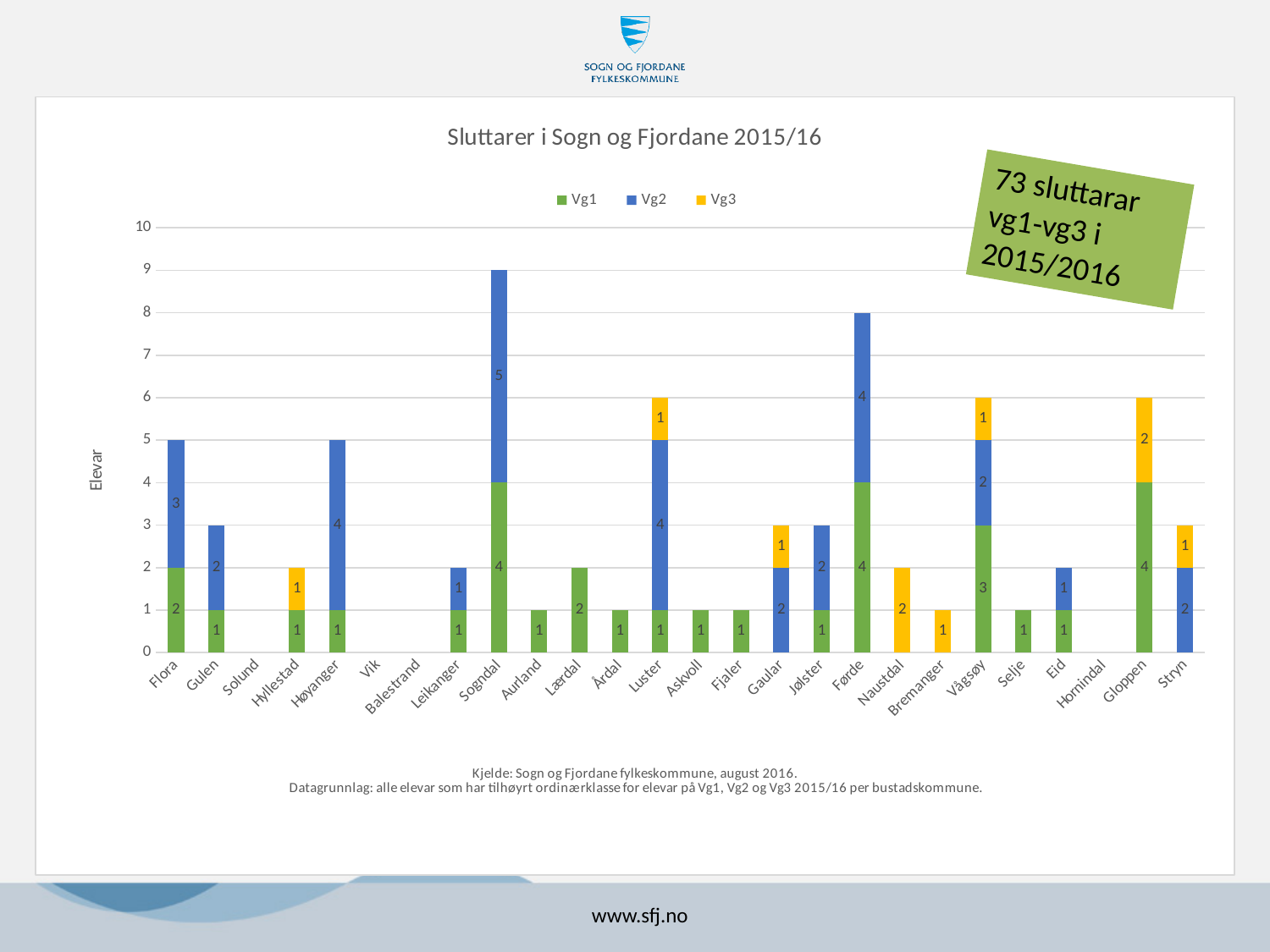
What kind of chart is shown on the slide? Stacked bar chart What is the difference between the Vg2 value for Høyanger and the Vg2 value for Gulen? 2 What is the Vg3 value for Naustdal? 2 What is the total height of the stacked bar for Luster? 6 What is the total height of the stacked bar for Vågsøy? 6 How many series does the legend list? 3 Which is larger, the Vg1 value for Sogndal or the Vg1 value for Vågsøy? Sogndal What is the Vg3 value for Gloppen? 2 What is the Vg2 value for Sogndal? 5 What is the title of the chart? Sluttarer i Sogn og Fjordane 2015/16 What is the Vg1 value for Førde? 4 Which municipality has the highest total number of sluttarar? Sogndal